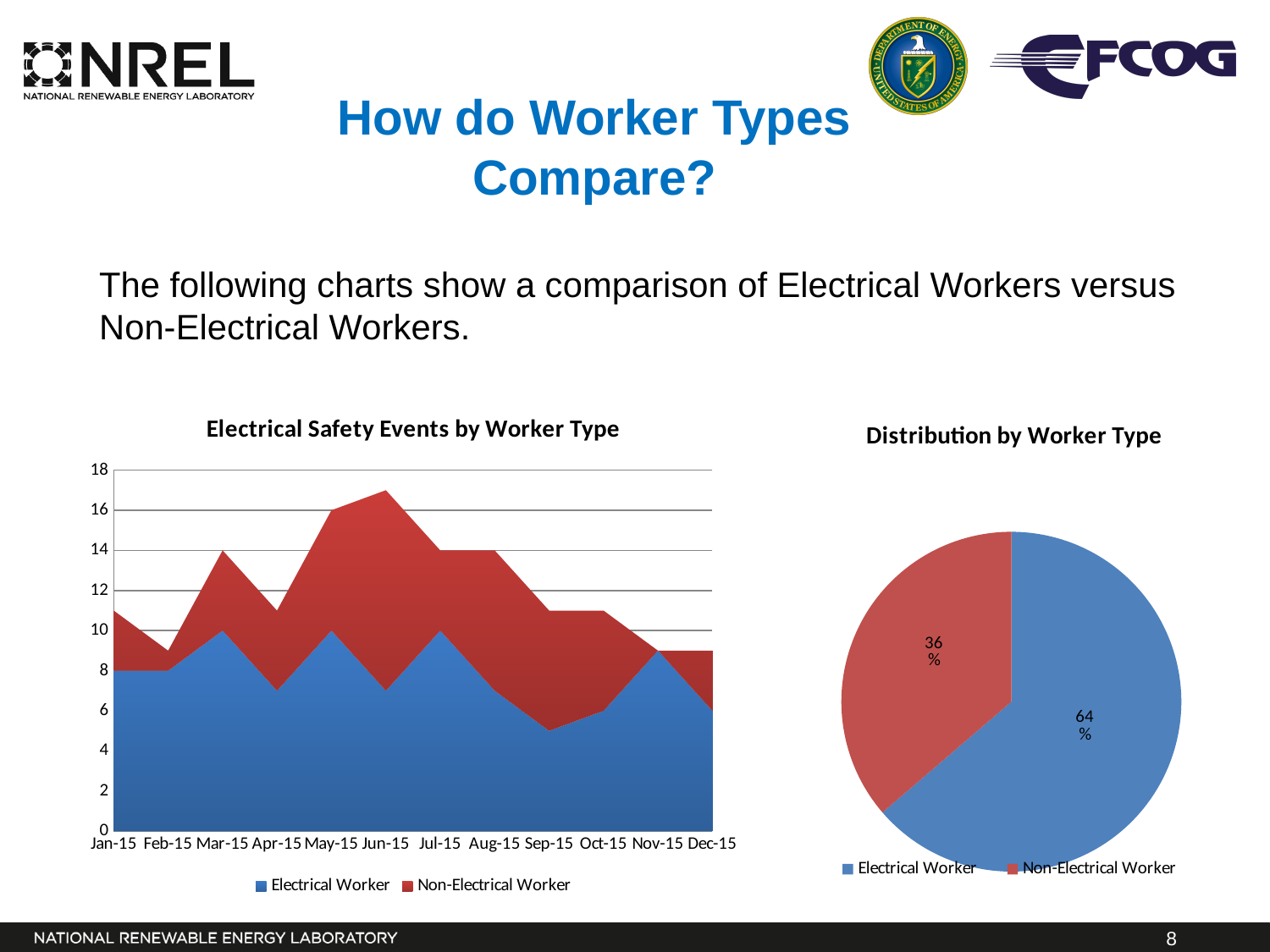
In the 'Distribution by Worker Type' pie chart, what share is labelled for Electrical Worker? 64% In the 'Distribution by Worker Type' pie chart, what share is labelled for Non-Electrical Worker? 36% In the 'Distribution by Worker Type' pie chart, by how many percentage points does the Electrical Worker share exceed the Non-Electrical Worker share? 28% In the 'Distribution by Worker Type' pie chart, how many slices are there? 2 In 'Electrical Safety Events by Worker Type', is the combined total for Jun-15 greater or less than 16? greater How many series does the legend of 'Electrical Safety Events by Worker Type' list? 2 What kind of chart is 'Electrical Safety Events by Worker Type'? Stacked area chart In 'Electrical Safety Events by Worker Type', which colour represents Non-Electrical Worker? Red In the 'Distribution by Worker Type' pie chart, which worker type has the larger slice? Electrical Worker In 'Electrical Safety Events by Worker Type', is the Electrical Worker value for Sep-15 greater or less than 6? less In 'Electrical Safety Events by Worker Type', in which month is the combined total of both worker types highest? Jun-15 How many months are shown on the x axis of 'Electrical Safety Events by Worker Type'? 12